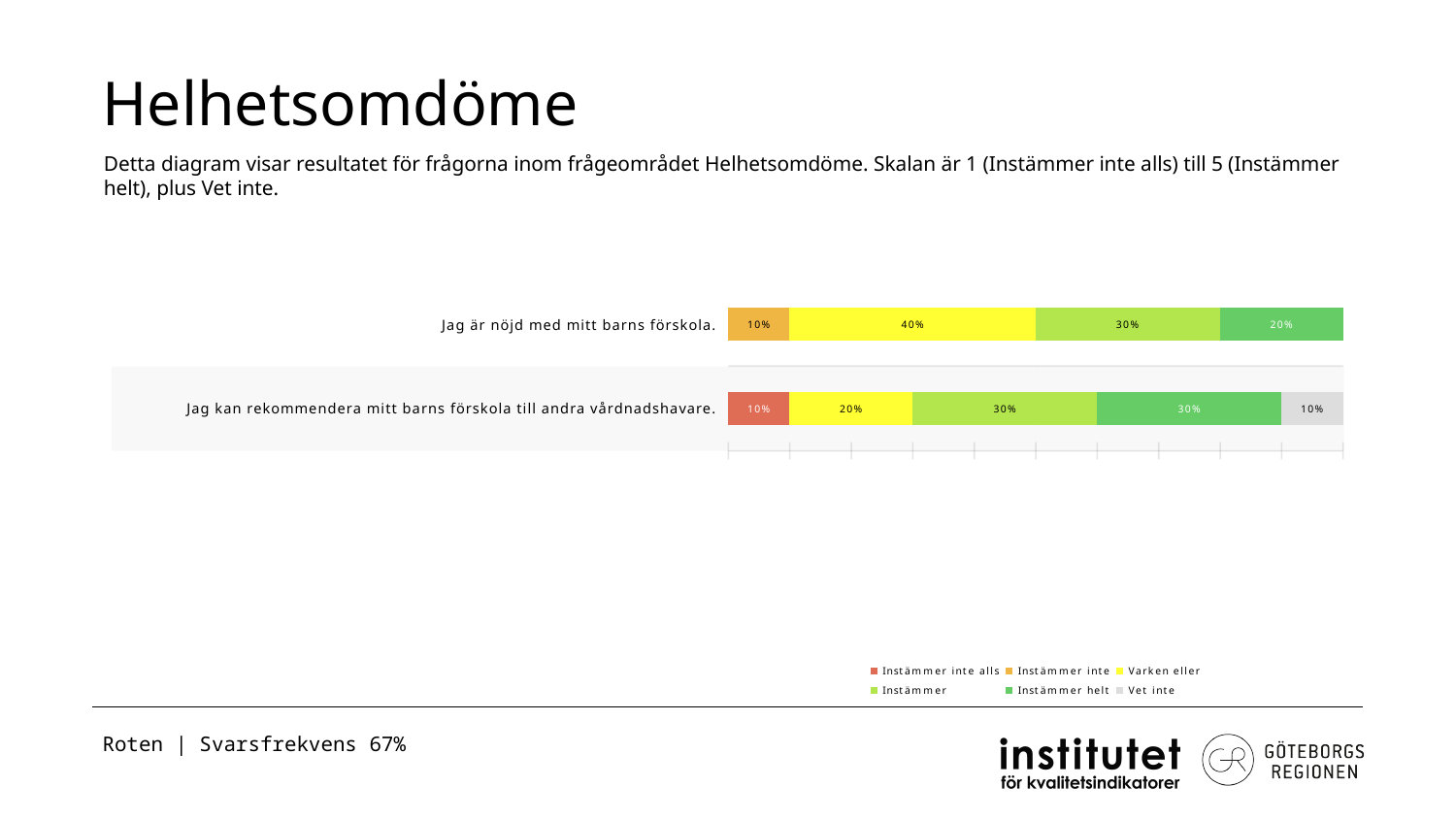
What is the value of "Vet inte" for "Jag kan rekommendera mitt barns förskola till andra vårdnadshavare."? 10% Which statement has the larger "Varken eller" share? Jag är nöjd med mitt barns förskola. What kind of chart is shown on the slide? Stacked bar chart Which response category has the largest segment in the bar for "Jag är nöjd med mitt barns förskola."? Varken eller How many statements (categories) are plotted in the chart? 2 Which legend entry is shown in grey? Vet inte What is the total of all segments in the bar for "Jag är nöjd med mitt barns förskola."? 100% What is the value of "Instämmer helt" for "Jag är nöjd med mitt barns förskola."? 20% What is the difference in the "Varken eller" share between "Jag är nöjd med mitt barns förskola." and "Jag kan rekommendera mitt barns förskola till andra vårdnadshavare."? 20% What is the value of "Instämmer helt" for "Jag kan rekommendera mitt barns förskola till andra vårdnadshavare."? 30% How many series does the legend list? 6 What is the value of "Varken eller" for "Jag är nöjd med mitt barns förskola."? 40%